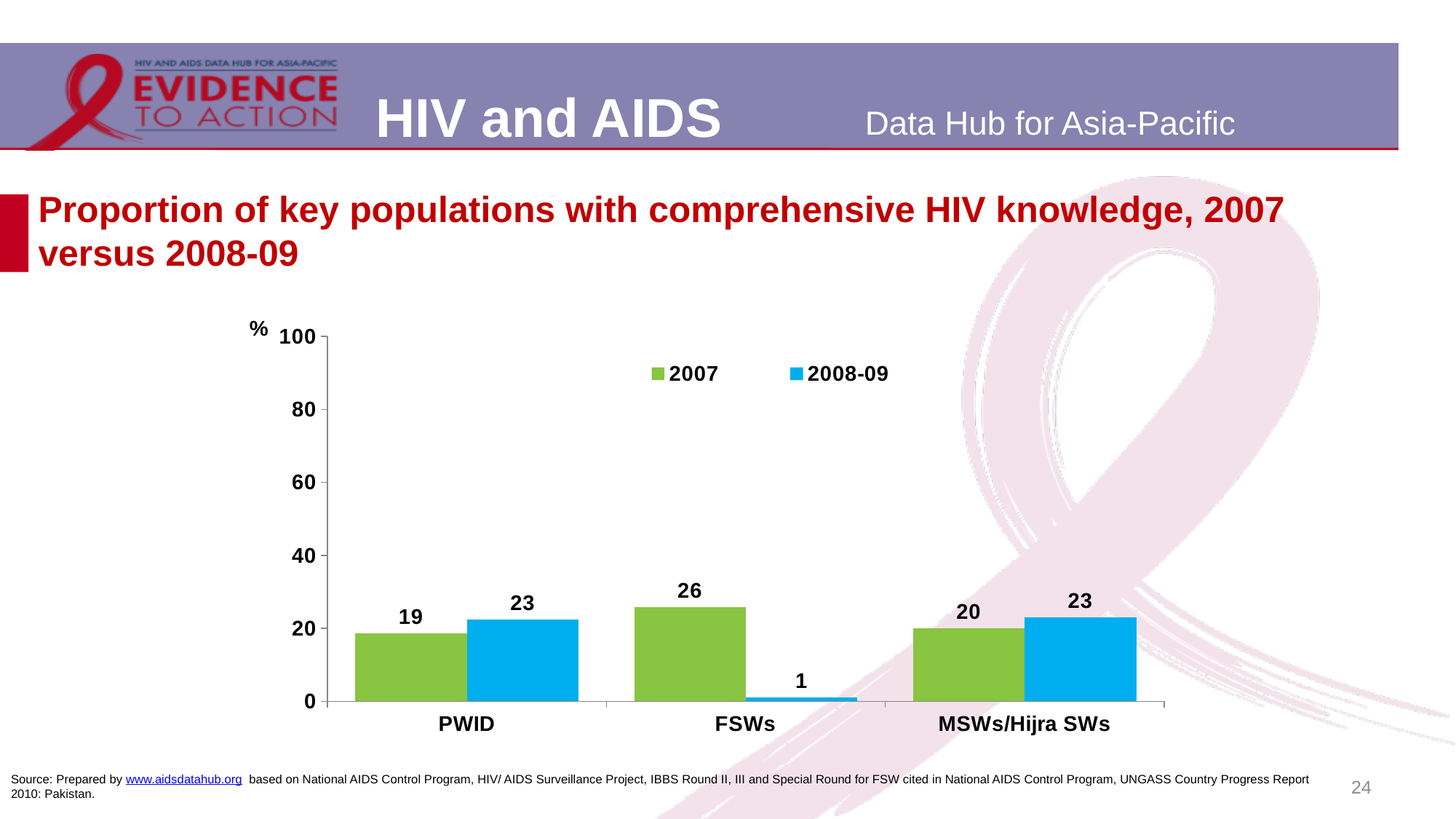
What is the difference between the 2008-09 and 2007 values for PWID? 4 What is the value for MSWs/Hijra SWs in 2008-09? 23 How many categories are shown on the x axis? 3 What kind of chart is shown on the slide? bar chart Is the value for FSWs in 2007 greater or less than 40? less What is the difference between the 2007 and 2008-09 values for FSWs? 25 Which category has the highest value in 2007? FSWs Which category has the lowest value in 2008-09? FSWs What is the value for PWID in 2007? 19 What is the value for FSWs in 2008-09? 1 How many series does the legend list? 2 Which is larger for MSWs/Hijra SWs, the 2007 value or the 2008-09 value? 2008-09